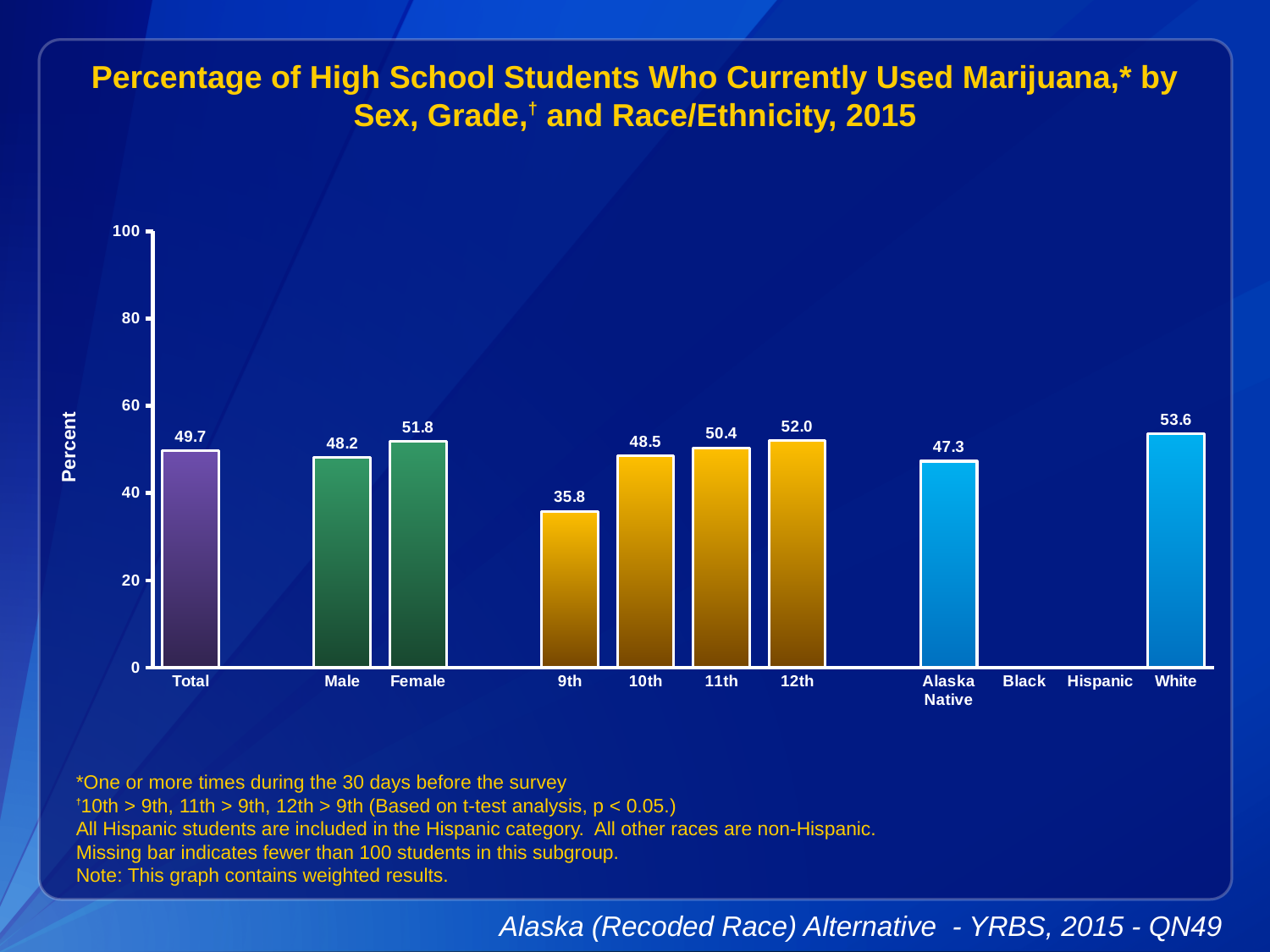
How many bars are plotted on the chart? 9 What is the value for White students? 53.6 Which is larger, the value for 11th grade or the value for 10th grade? 11th Which categories on the x axis have no bar plotted? Black and Hispanic Is the value for Alaska Native greater or less than 40? greater Which category has the highest value? White What is the difference between the 12th grade and 9th grade values? 16.2 Which category has the lowest value among the bars shown? 9th What percentage of 9th grade students currently used marijuana? 35.8 What is the value for Total? 49.7 What kind of chart is shown on the slide? bar chart What is the difference between the Female and Male values? 3.6